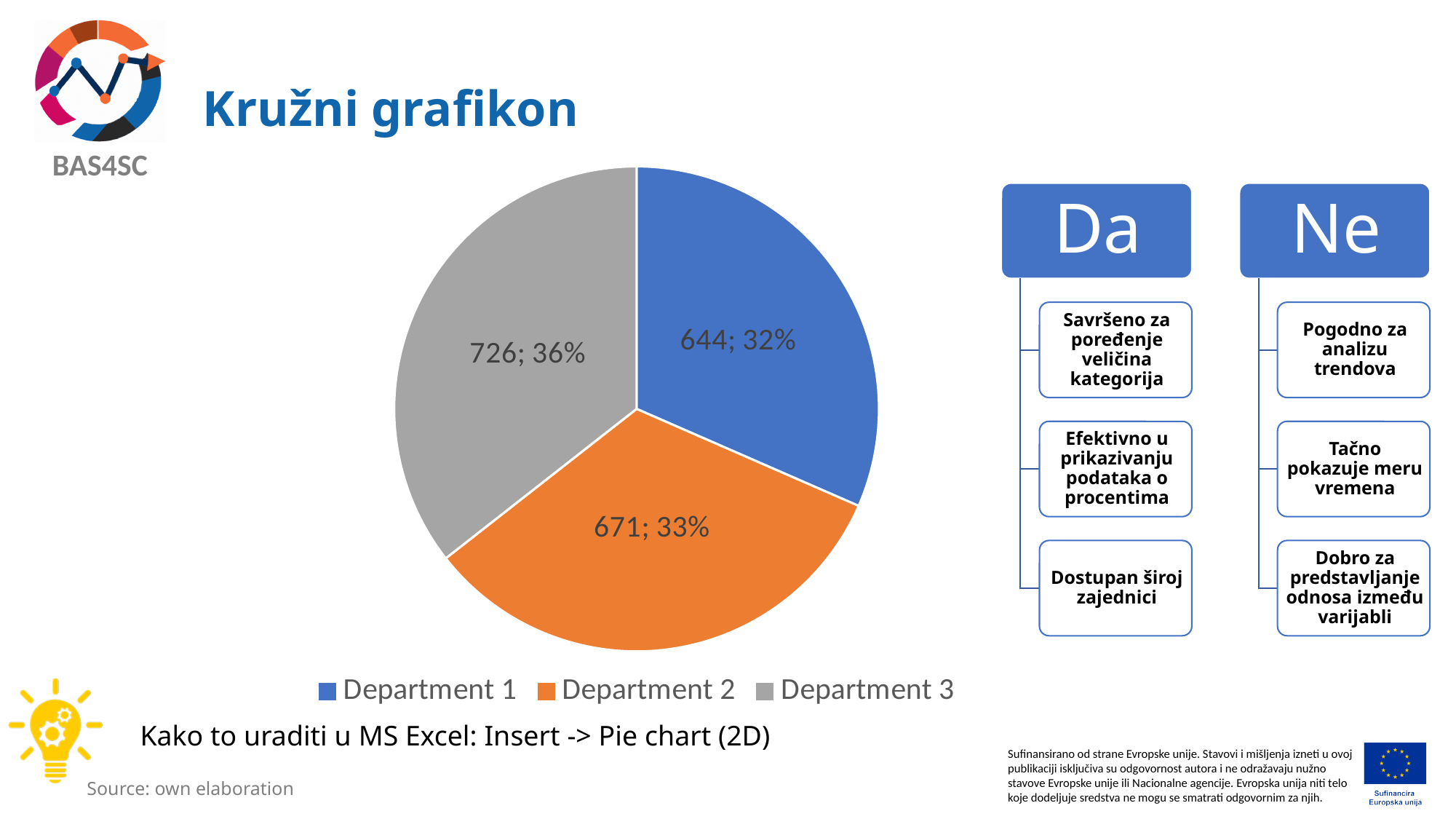
What is the value for Department 2? 671 How many entries does the legend list? 3 How many slices does the pie chart have? 3 Which department has the smallest slice? Department 1 What colour is the slice for Department 2? orange What is the difference between the values for Department 3 and Department 1? 82 What kind of chart is shown on the slide? pie chart Which department has the largest slice? Department 3 What is the value for Department 3? 726 What share of the pie does Department 1 represent? 32% What is the value for Department 1? 644 What share of the pie does Department 3 represent? 36%